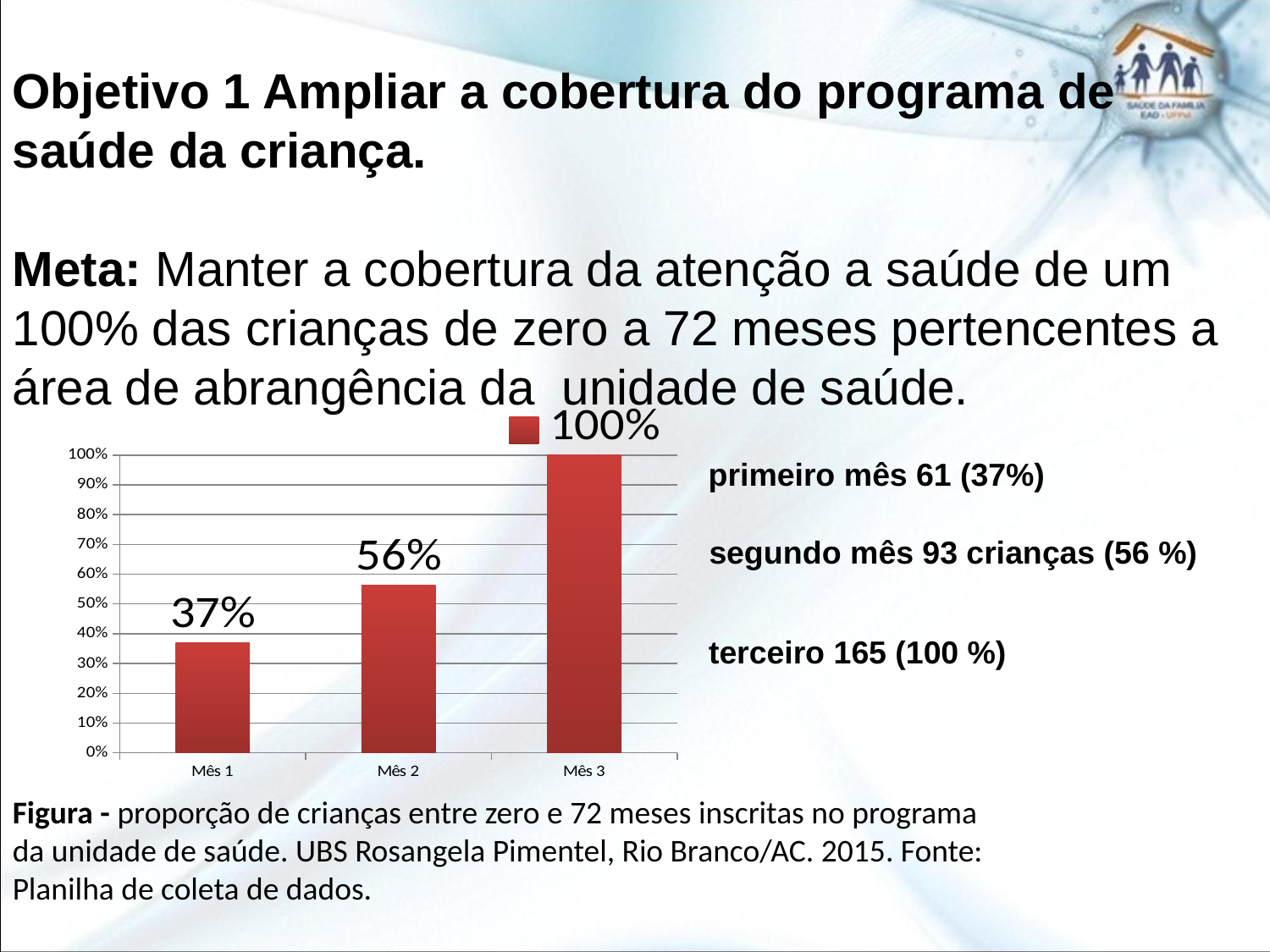
Do the values rise or fall from Mês 1 to Mês 3? rise What is the difference between the values for Mês 3 and Mês 1? 63% Which month has the highest value? Mês 3 What is the difference between the values for Mês 2 and Mês 1? 19% Which is larger, the value for Mês 2 or the value for Mês 1? Mês 2 Which month has the lowest value? Mês 1 What is the value for Mês 2? 56% Is the value for Mês 2 greater or less than 50%? greater What is the value for Mês 1? 37% What is the value for Mês 3? 100% What kind of chart is shown on the slide? bar chart How many categories are shown on the x axis? 3